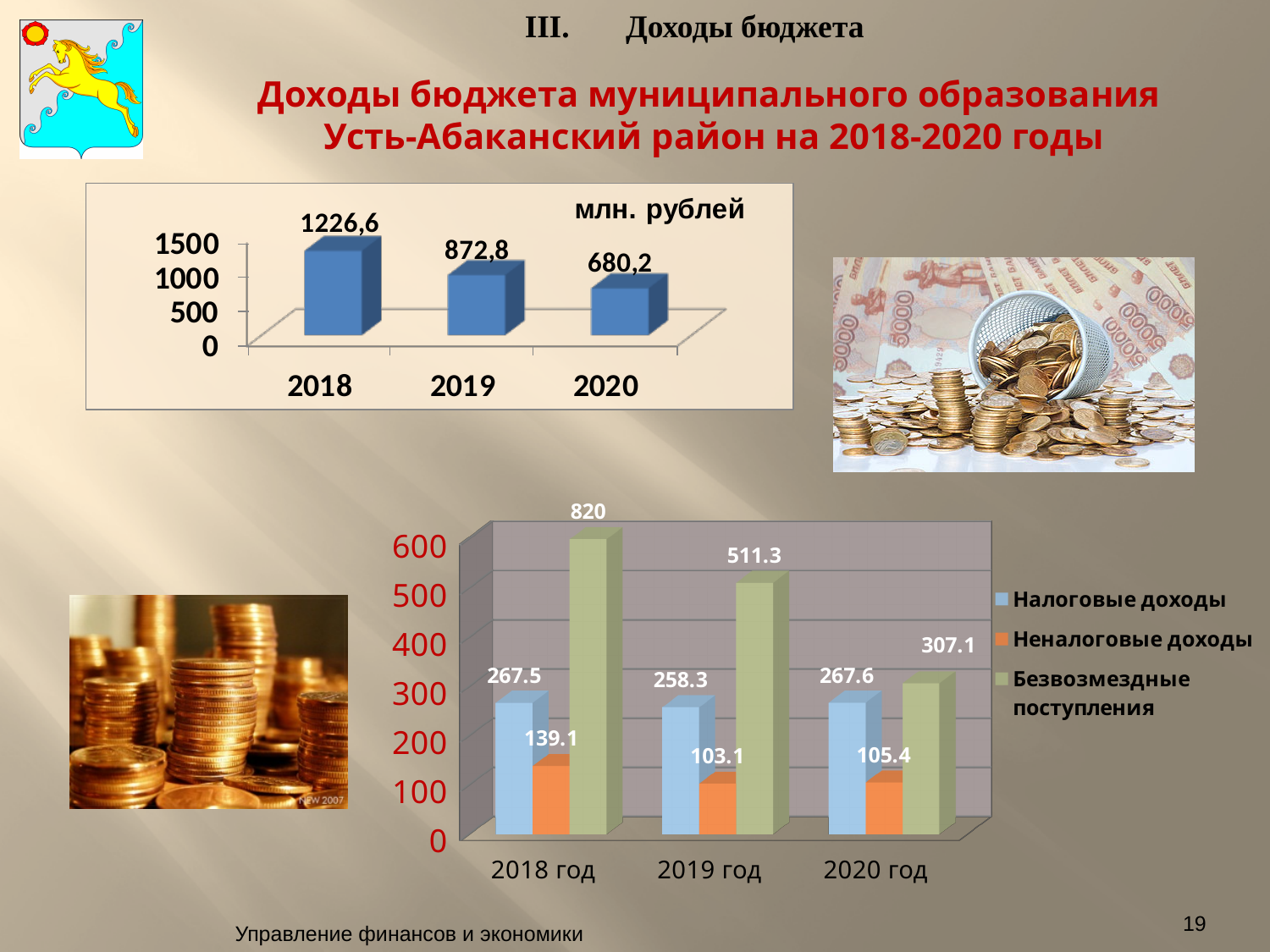
In the top chart, what unit is shown for the values? млн. рублей In the bottom chart, what is the value of Неналоговые доходы for 2019 год? 103.1 In the top chart, what is the value for 2020? 680,2 In the top chart, what is the difference between the 2018 and 2019 values? 353,8 In the top chart, what is the value for 2018? 1226,6 In the top chart, which year has the lowest value? 2020 In the top chart, do the values rise or fall from 2018 to 2020? fall In the bottom chart, how many series does the legend list? 3 In the bottom chart, what is the value of Безвозмездные поступления for 2018 год? 820 What kind of chart is the bottom chart? bar chart In the bottom chart, which is larger for 2020 год: Налоговые доходы or Безвозмездные поступления? Безвозмездные поступления In the bottom chart, what is the difference between Безвозмездные поступления in 2018 год and 2020 год? 512.9